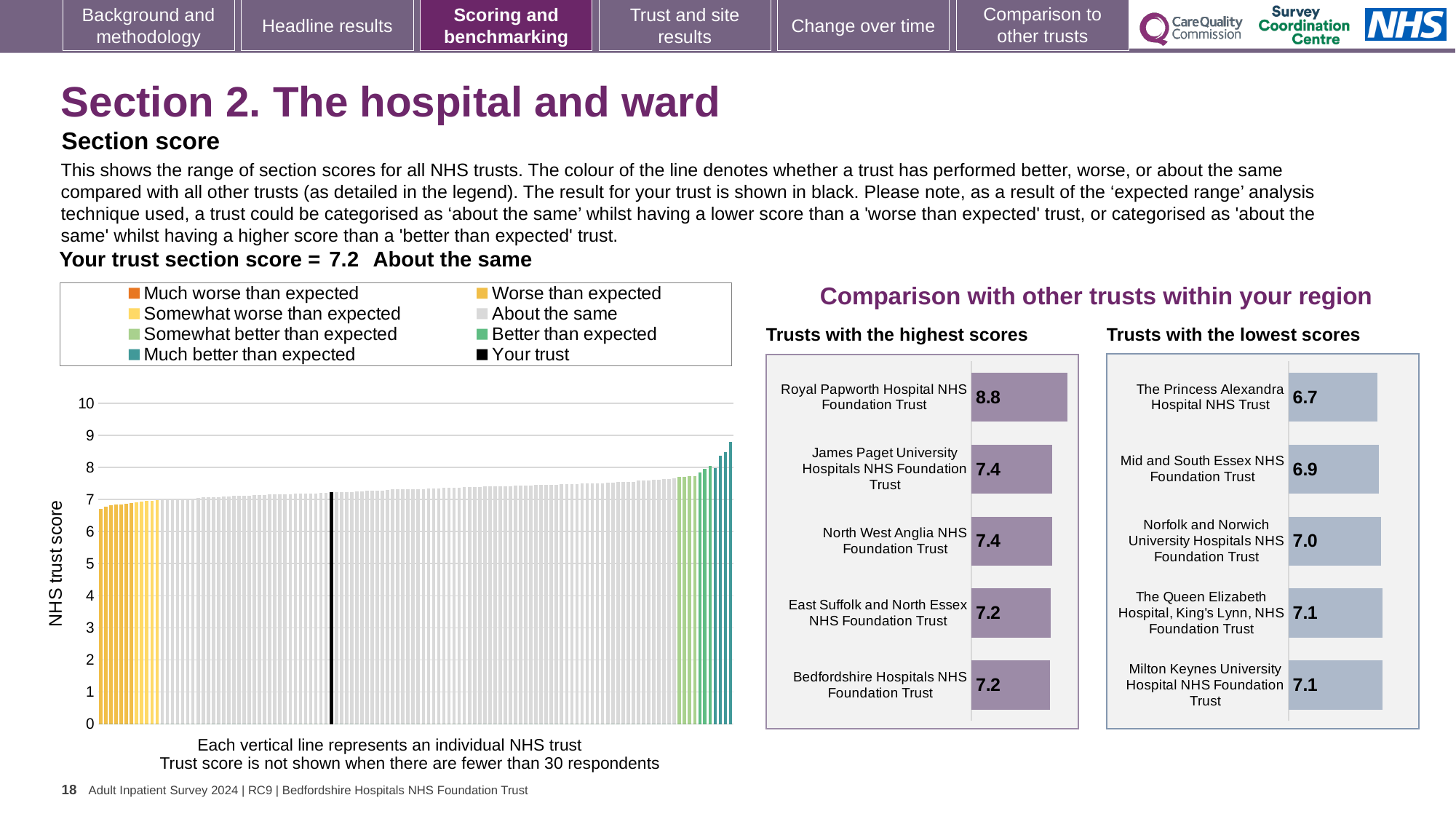
In the large chart on the left showing all NHS trusts, what is the section score for your trust (the black bar)? 7.2 How many entries does the legend of the large chart on the left list? 8 In the 'Trusts with the lowest scores' chart, which trust has the lowest score? The Princess Alexandra Hospital NHS Trust In the 'Trusts with the highest scores' chart, what is the difference between the scores of Royal Papworth Hospital NHS Foundation Trust and Bedfordshire Hospitals NHS Foundation Trust? 1.6 In the 'Trusts with the highest scores' chart, what is the score for Royal Papworth Hospital NHS Foundation Trust? 8.8 In the 'Trusts with the lowest scores' chart, what is the score for The Princess Alexandra Hospital NHS Trust? 6.7 In the 'Trusts with the lowest scores' chart, how much higher is the score of Norfolk and Norwich University Hospitals NHS Foundation Trust than that of The Princess Alexandra Hospital NHS Trust? 0.3 In the 'Trusts with the lowest scores' chart, what is the score for Milton Keynes University Hospital NHS Foundation Trust? 7.1 How many trusts are shown in the 'Trusts with the highest scores' chart? 5 In the 'Trusts with the highest scores' chart, which trust has the highest score? Royal Papworth Hospital NHS Foundation Trust What kind of chart is the 'Trusts with the lowest scores' chart? bar chart In the 'Trusts with the lowest scores' chart, which has the higher score: Mid and South Essex NHS Foundation Trust or Norfolk and Norwich University Hospitals NHS Foundation Trust? Norfolk and Norwich University Hospitals NHS Foundation Trust